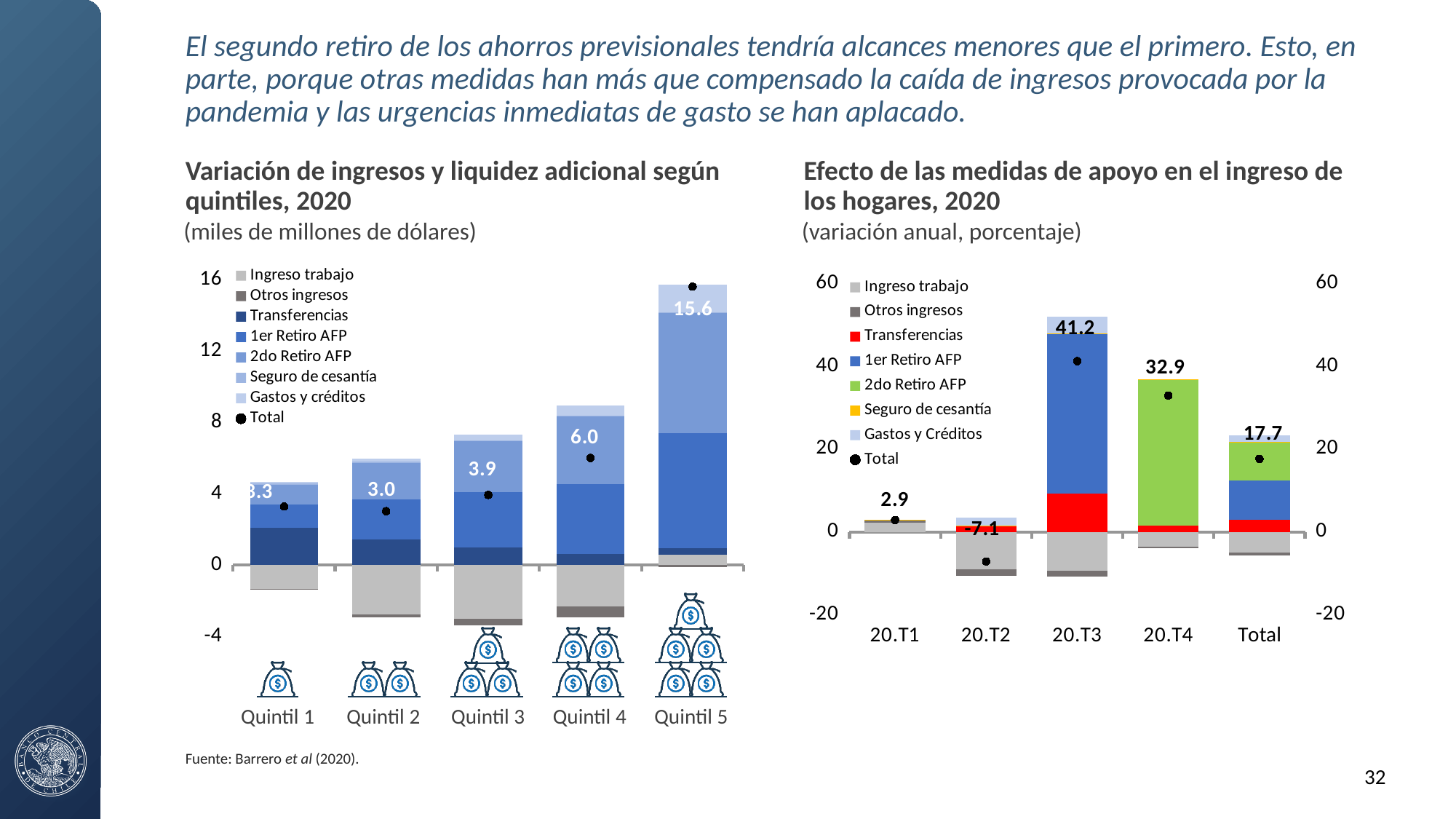
In the chart 'Efecto de las medidas de apoyo en el ingreso de los hogares, 2020', what is the difference between the Total values for 20.T3 and 20.T4? 8.3 In the chart 'Variación de ingresos y liquidez adicional según quintiles, 2020', which quintile has the highest Total value? Quintil 5 In the chart 'Variación de ingresos y liquidez adicional según quintiles, 2020', what is the Total value for Quintil 4? 6.0 In the chart 'Variación de ingresos y liquidez adicional según quintiles, 2020', is the Total value for Quintil 3 larger or smaller than that for Quintil 2? larger How many categories are shown on the x axis of the chart 'Efecto de las medidas de apoyo en el ingreso de los hogares, 2020'? 5 In the chart 'Efecto de las medidas de apoyo en el ingreso de los hogares, 2020', which category has the lowest Total value? 20.T2 In the chart 'Efecto de las medidas de apoyo en el ingreso de los hogares, 2020', what is the Total value for 20.T2? -7.1 In the chart 'Variación de ingresos y liquidez adicional según quintiles, 2020', what is the Total value for Quintil 5? 15.6 How many entries does the legend of the chart 'Variación de ingresos y liquidez adicional según quintiles, 2020' list? 8 In the chart 'Efecto de las medidas de apoyo en el ingreso de los hogares, 2020', what is the Total value for 20.T3? 41.2 In the chart 'Efecto de las medidas de apoyo en el ingreso de los hogares, 2020', which category has the highest Total value? 20.T3 In the chart 'Efecto de las medidas de apoyo en el ingreso de los hogares, 2020', what is the Total value for the 'Total' category? 17.7